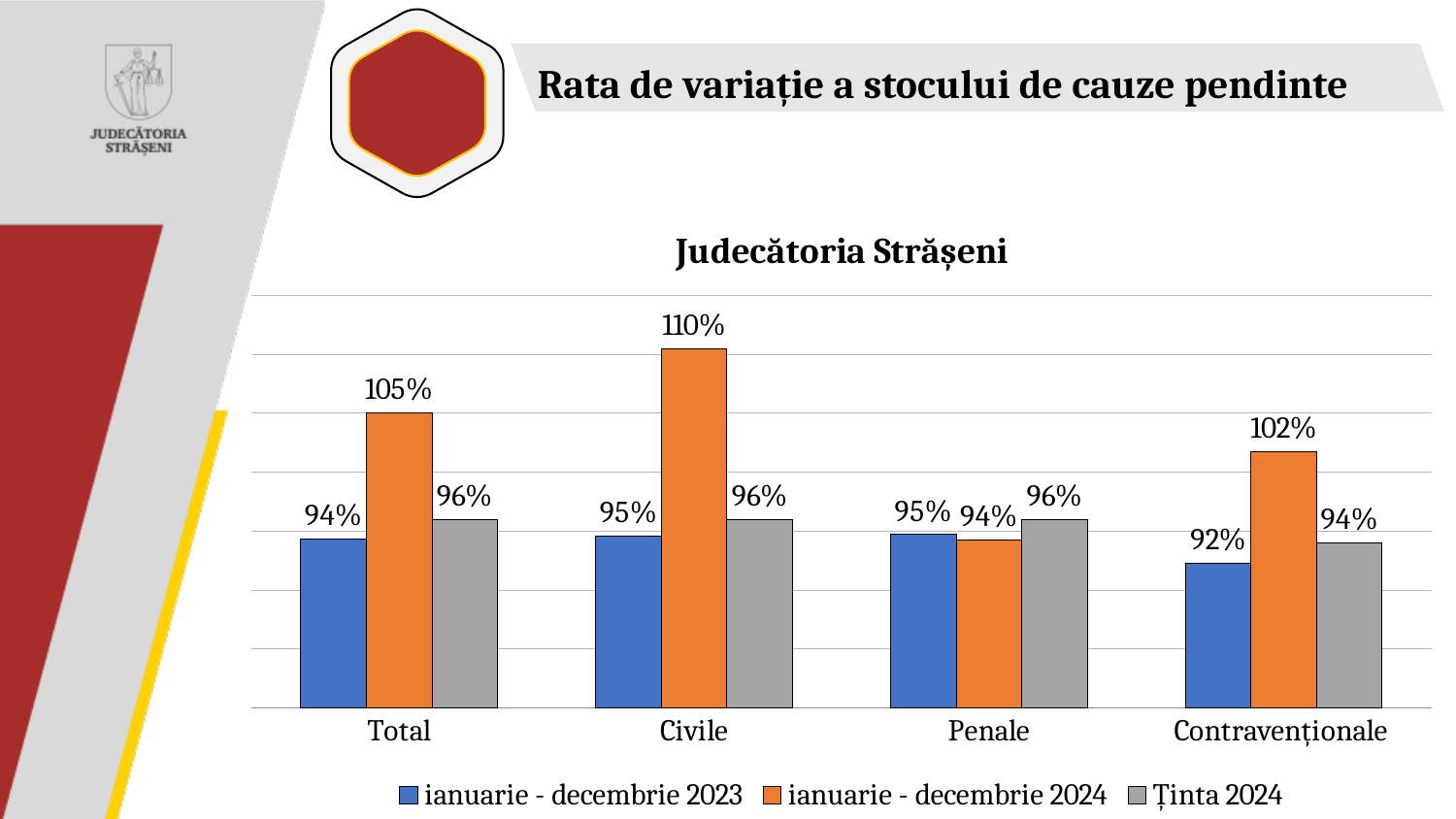
What is the value for Civile in the ianuarie - decembrie 2024 series? 110% How many series does the legend list? 3 What is the difference between the ianuarie - decembrie 2024 and ianuarie - decembrie 2023 values for Total? 11% What kind of chart is shown on the slide? bar chart Which category has the highest value in the ianuarie - decembrie 2024 series? Civile Which category has the lowest value in the ianuarie - decembrie 2023 series? Contravenționale What is the Ținta 2024 value for Penale? 96% What is the value for Contravenționale in the ianuarie - decembrie 2023 series? 92% What is the title of the chart? Judecătoria Strășeni For Penale, which is larger: the ianuarie - decembrie 2023 value or the ianuarie - decembrie 2024 value? ianuarie - decembrie 2023 Which colour represents the Ținta 2024 series? grey How many categories are shown on the x axis? 4